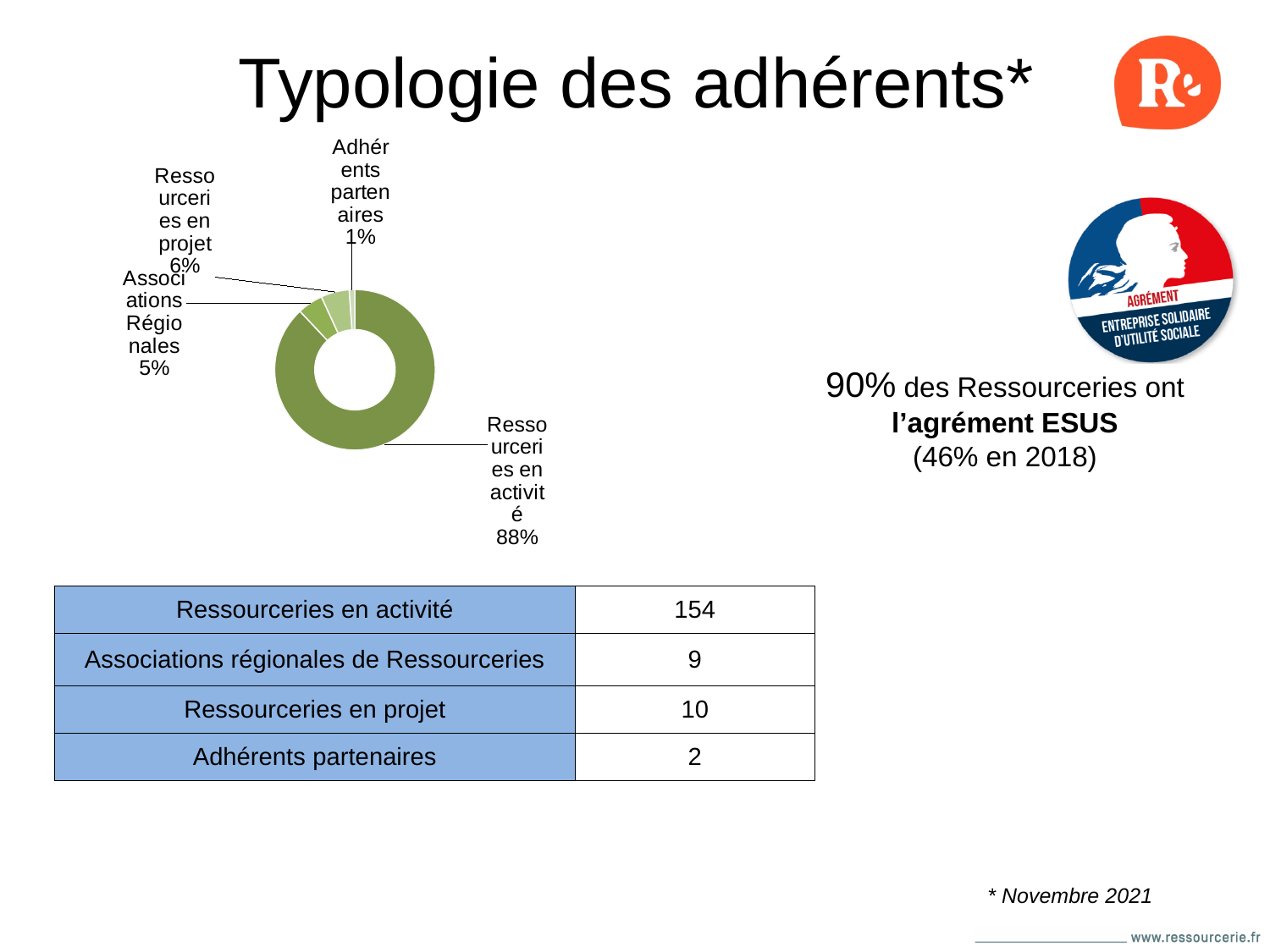
How many slices does the doughnut chart have? 4 Which slice is larger: 'Ressourceries en projet' or 'Associations Régionales'? Ressourceries en projet What is the difference in percentage points between the 'Associations Régionales' slice and the 'Adhérents partenaires' slice? 4 percentage points What share of the doughnut chart is 'Adhérents partenaires'? 1% What share of the doughnut chart is 'Ressourceries en projet'? 6% Which category has the smallest slice in the doughnut chart? Adhérents partenaires What share of the doughnut chart is 'Associations Régionales'? 5% What kind of chart is shown on the slide? Doughnut (pie) chart Which category has the largest slice in the doughnut chart? Ressourceries en activité What is the difference in percentage points between the 'Ressourceries en activité' slice and the 'Ressourceries en projet' slice? 82 percentage points What is the title of the slide containing the doughnut chart? Typologie des adhérents*